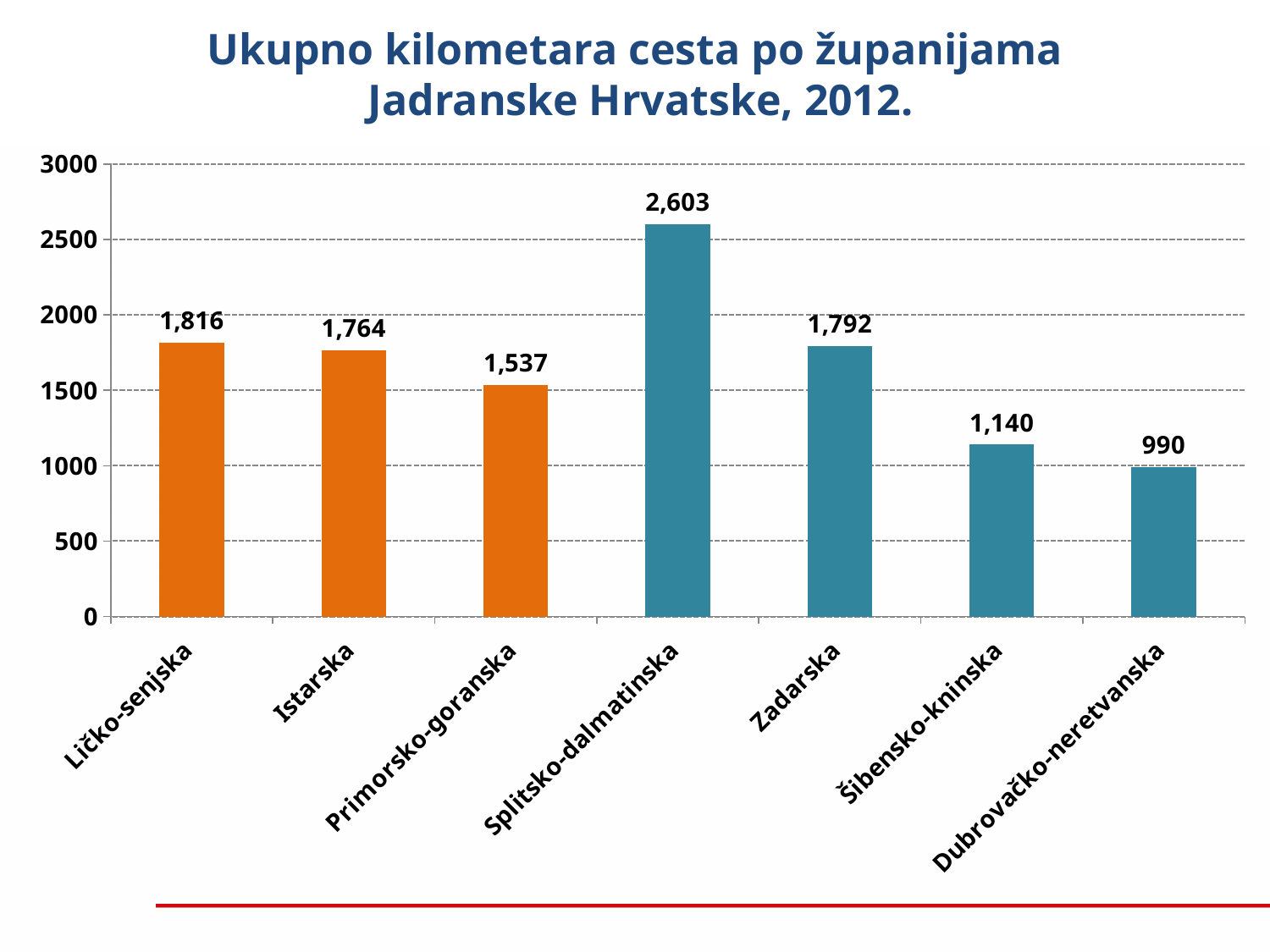
Which is larger, the value for Zadarska or the value for Šibensko-kninska? Zadarska What is the difference between the values for Splitsko-dalmatinska and Zadarska? 811 Which county has the lowest value? Dubrovačko-neretvanska What is the difference between the values for Ličko-senjska and Istarska? 52 What kind of chart is shown on the slide? bar chart What is the value for Splitsko-dalmatinska? 2,603 What is the title of the chart? Ukupno kilometara cesta po županijama Jadranske Hrvatske, 2012. What is the value for Dubrovačko-neretvanska? 990 Which county has the highest value? Splitsko-dalmatinska What is the value for Primorsko-goranska? 1,537 Is the value for Šibensko-kninska greater or less than 1000? greater How many counties are shown on the chart? 7